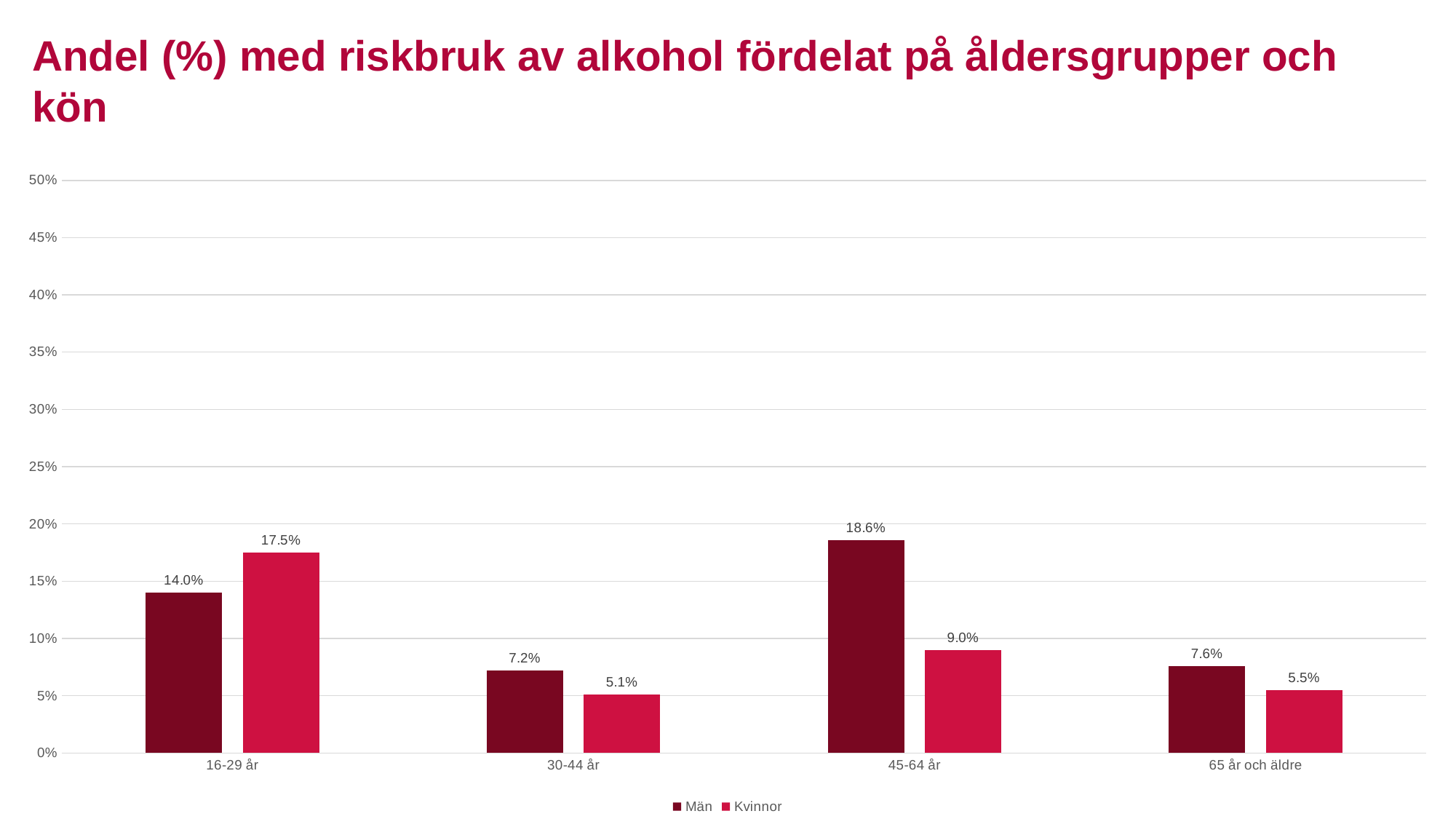
What is the value for Män in the 16-29 år age group? 14.0% What is the value for Kvinnor in the 45-64 år age group? 9.0% What is the difference between the Män and Kvinnor values in the 45-64 år age group? 9.6% How many series does the legend list? 2 What kind of chart is shown on the slide? bar chart How many age groups are shown on the x axis? 4 What are the two series named in the legend? Män and Kvinnor Which is larger in the 16-29 år age group, the value for Män or for Kvinnor? Kvinnor Which age group has the highest value for Män? 45-64 år Is the value for Män in the 30-44 år age group greater or less than 10%? less Which age group has the lowest value for Kvinnor? 30-44 år What is the value for Kvinnor in the 65 år och äldre age group? 5.5%